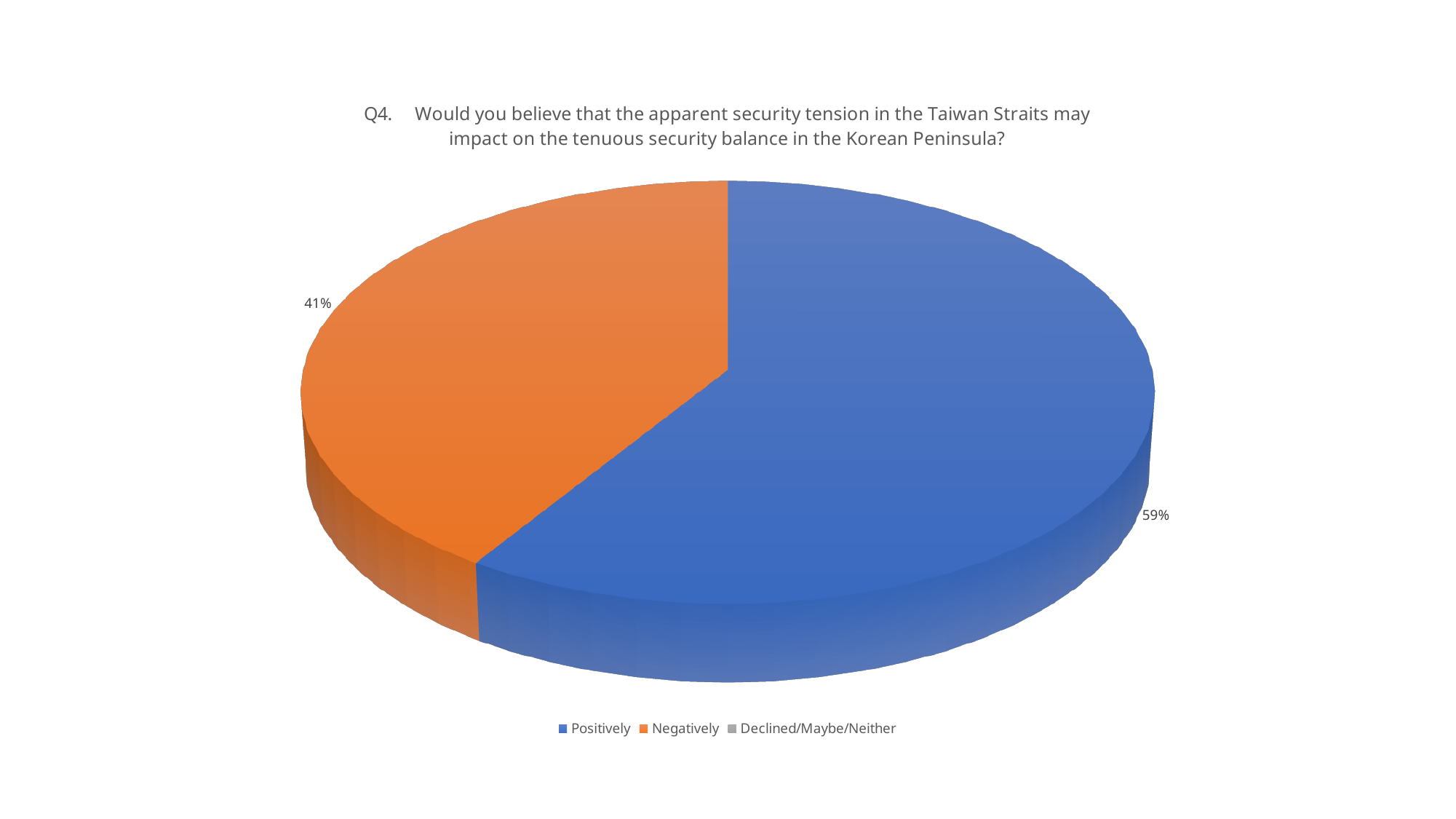
Is the share for Positively larger or smaller than the share for Negatively? larger How many entries does the legend list? 3 Which response category has the largest share of the pie? Positively Which of the two labelled slices is smaller, Positively or Negatively? Negatively What kind of chart is shown on the slide? pie chart What colour is the Negatively slice? orange What percentage of respondents answered Negatively? 41% What is the difference in percentage points between the Positively and Negatively slices? 18 What percentage of respondents answered Positively? 59% Is the value for Negatively greater or less than 50%? less What share of the pie does the Positively slice represent? 59% What is the third legend entry listed after Positively and Negatively? Declined/Maybe/Neither